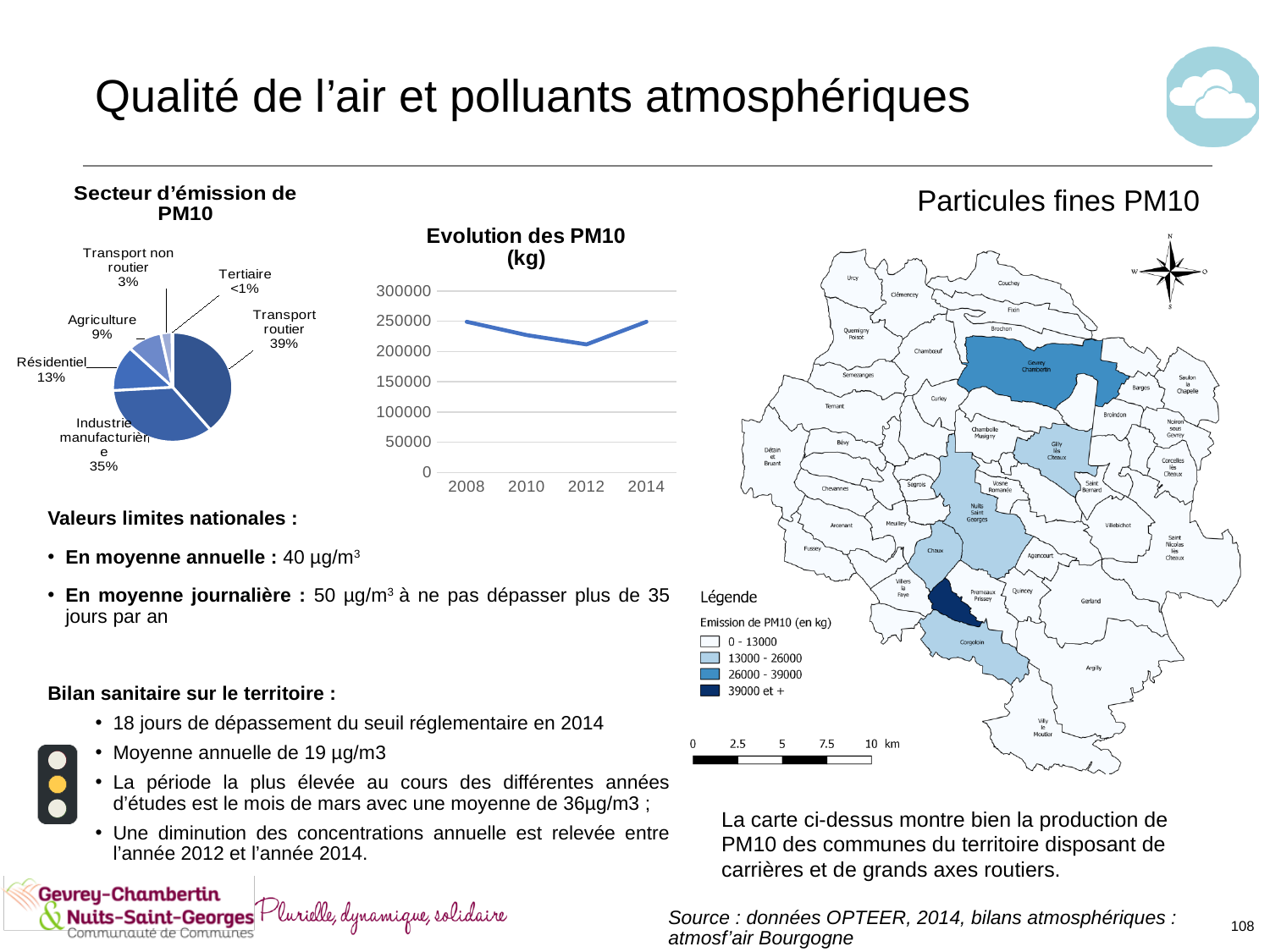
In the pie chart 'Secteur d'émission de PM10', how many sectors are shown? 6 In the pie chart 'Secteur d'émission de PM10', what is the difference in percentage points between Transport routier and Industrie manufacturière? 4 percentage points In the pie chart 'Secteur d'émission de PM10', what share is attributed to Agriculture? 9% In the chart 'Evolution des PM10 (kg)', do the values rise or fall between 2008 and 2012? fall In the pie chart 'Secteur d'émission de PM10', which sector has the smallest share? Tertiaire In the chart 'Evolution des PM10 (kg)', is the value for 2012 greater or less than 250000? less In the pie chart 'Secteur d'émission de PM10', what share is attributed to Industrie manufacturière? 35% In the pie chart 'Secteur d'émission de PM10', which sector has the largest share? Transport routier What kind of chart is 'Evolution des PM10 (kg)'? Line chart In the chart 'Evolution des PM10 (kg)', how many years are plotted on the x axis? 4 In the pie chart 'Secteur d'émission de PM10', what share is attributed to Résidentiel? 13% In the pie chart 'Secteur d'émission de PM10', what share is attributed to Transport routier? 39%